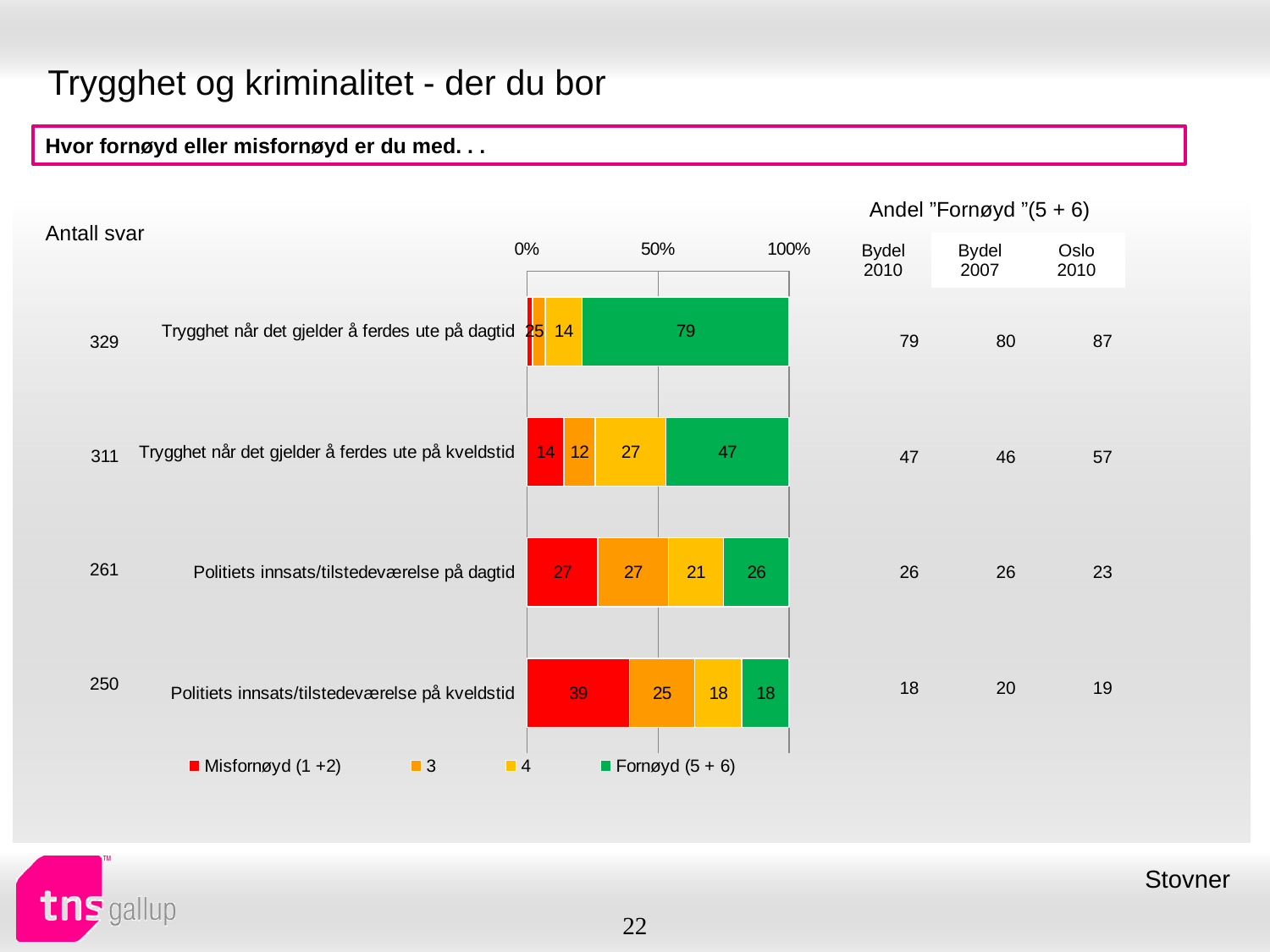
Which is larger: the Misfornøyd (1 +2) value for 'Politiets innsats/tilstedeværelse på kveldstid' or for 'Politiets innsats/tilstedeværelse på dagtid'? Politiets innsats/tilstedeværelse på kveldstid How many series does the chart legend list? 4 What is the Misfornøyd (1 +2) value for 'Politiets innsats/tilstedeværelse på kveldstid'? 39 Which category has the highest Fornøyd (5 + 6) value? Trygghet når det gjelder å ferdes ute på dagtid What is the value of series '4' for 'Politiets innsats/tilstedeværelse på dagtid'? 21 How many categories (bars) are plotted in the chart? 4 What kind of chart is shown on the slide? stacked bar chart What is the total of the stacked bar for 'Politiets innsats/tilstedeværelse på kveldstid'? 100 What is the Fornøyd (5 + 6) value for 'Trygghet når det gjelder å ferdes ute på dagtid'? 79 What is the value of series '3' for 'Trygghet når det gjelder å ferdes ute på kveldstid'? 12 What is the difference between the Fornøyd (5 + 6) values for 'Trygghet når det gjelder å ferdes ute på dagtid' and 'Trygghet når det gjelder å ferdes ute på kveldstid'? 32 Which category has the lowest Fornøyd (5 + 6) value? Politiets innsats/tilstedeværelse på kveldstid